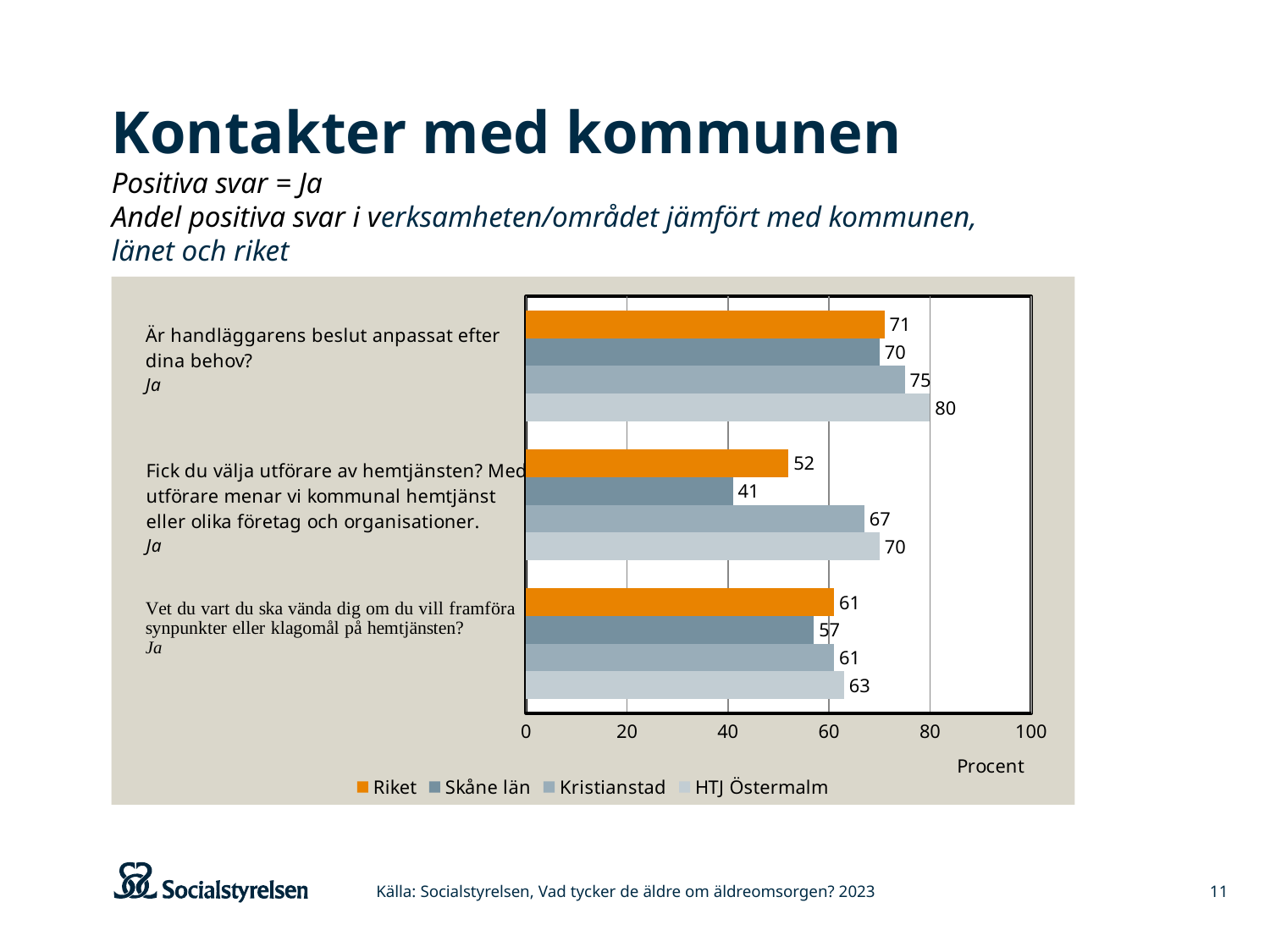
Is the value for Kristianstad for the question "Är handläggarens beslut anpassat efter dina behov?" greater or less than 60? greater Which series has the lowest value for the question "Är handläggarens beslut anpassat efter dina behov?"? Skåne län What is the value for Skåne län for the question "Fick du välja utförare av hemtjänsten?"? 41 How many question categories are plotted on the chart? 3 What is the value for HTJ Östermalm for the question "Är handläggarens beslut anpassat efter dina behov?"? 80 How many series does the legend list? 4 For the question "Vet du vart du ska vända dig om du vill framföra synpunkter eller klagomål på hemtjänsten?", which is larger: the value for HTJ Östermalm or the value for Skåne län? HTJ Östermalm What is the difference between the HTJ Östermalm and Riket values for the question "Fick du välja utförare av hemtjänsten?"? 18 Which series has the highest value for the question "Fick du välja utförare av hemtjänsten?"? HTJ Östermalm What is the value for Riket for the question "Vet du vart du ska vända dig om du vill framföra synpunkter eller klagomål på hemtjänsten?"? 61 What is the label on the horizontal axis of the chart? Procent What kind of chart is shown on the slide? Bar chart